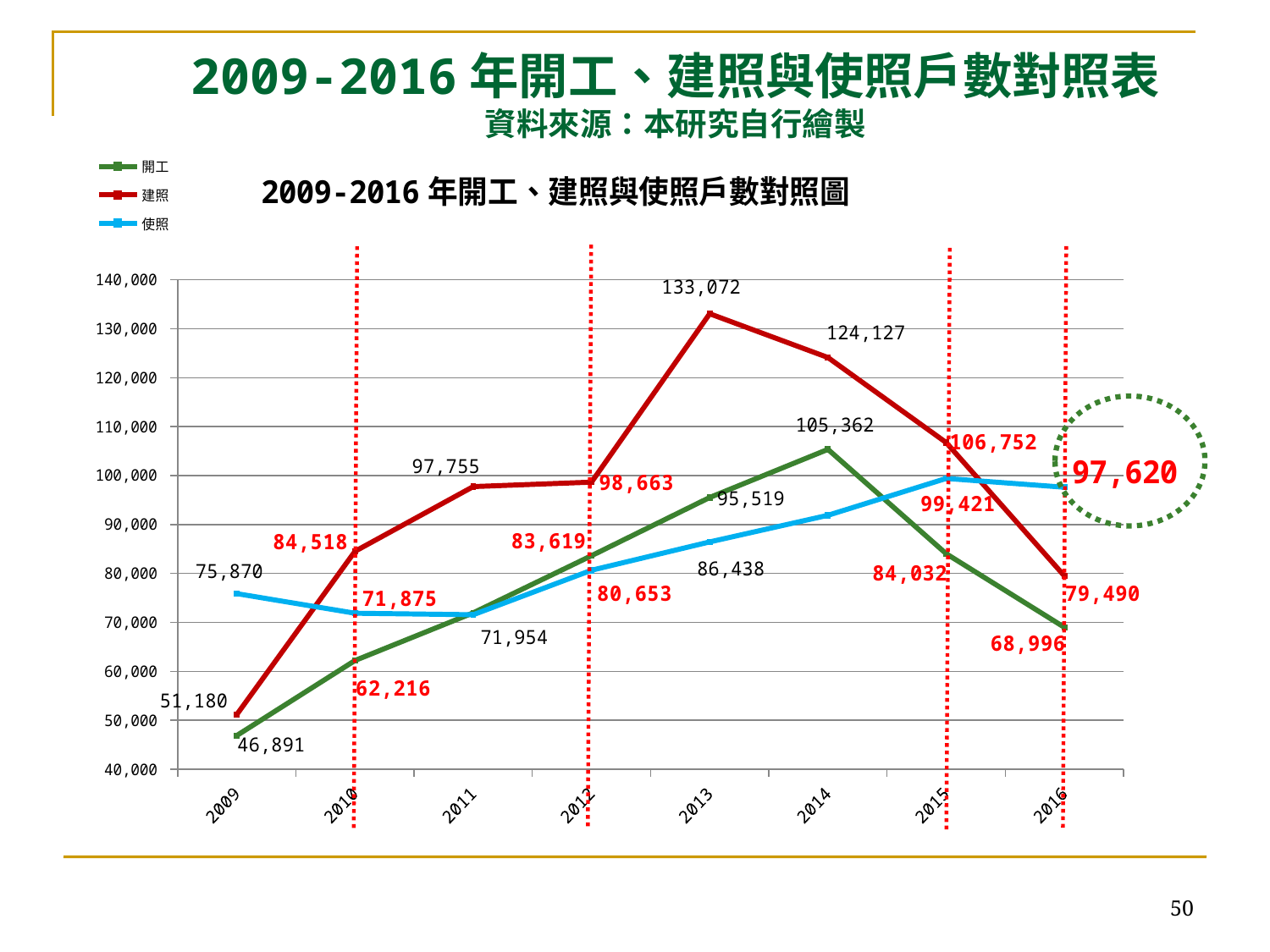
In 2016, which is larger: 建照 or 使照? 使照 How many years are plotted along the x axis? 8 What is the value of 開工 in 2014? 105,362 What is the difference between the 建照 values in 2013 and 2014? 8,945 What is the value of 使照 in 2016? 97,620 Does the 開工 series rise or fall from 2014 to 2016? fall Is the value for 使照 in 2014 greater or less than 100,000? less In which year is 開工 at its lowest value? 2009 What is the value of 建照 in 2013? 133,072 In which year does 建照 reach its highest value? 2013 How many series does the legend list? 3 What kind of chart is shown on the slide? line chart